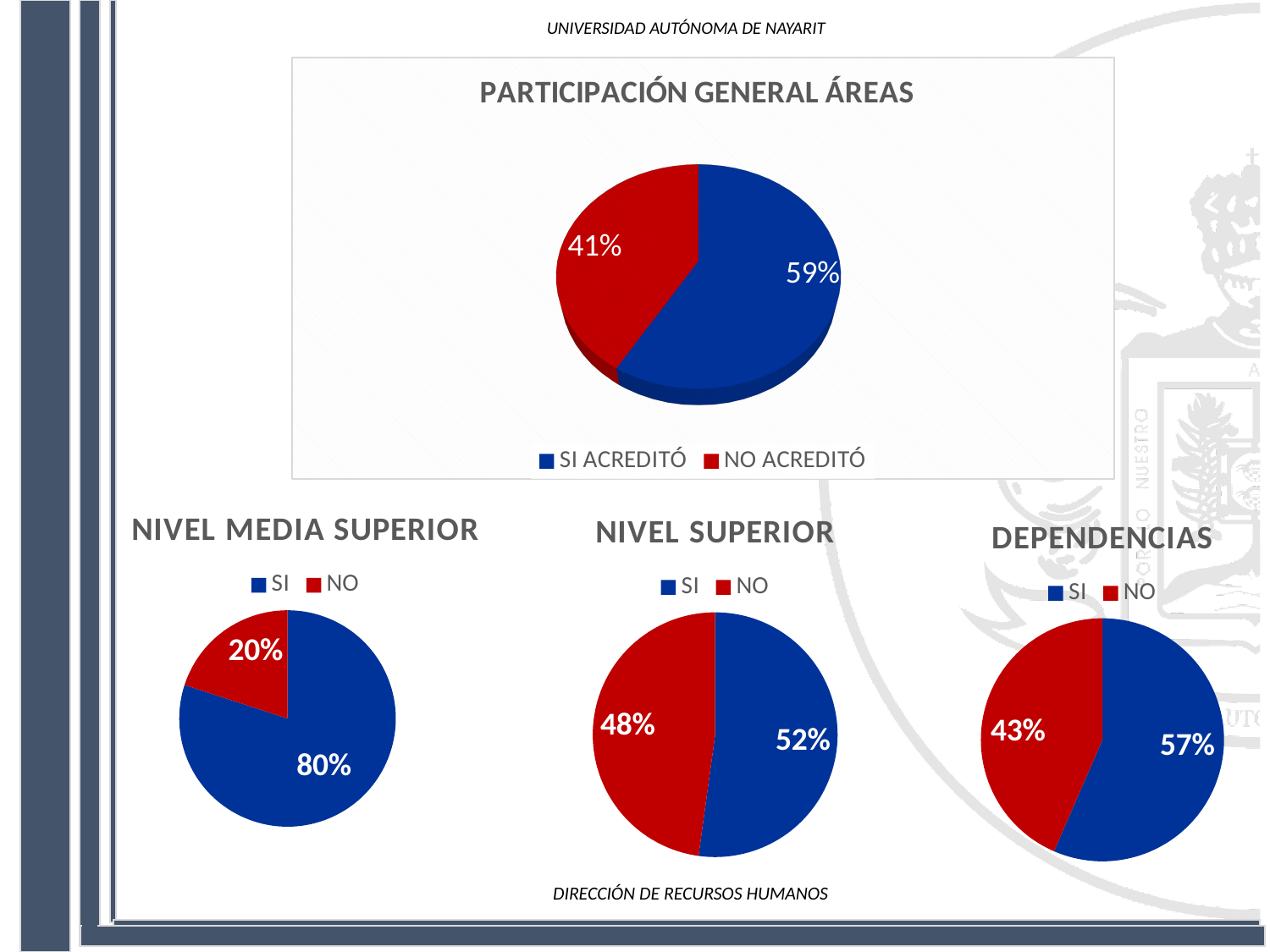
In the DEPENDENCIAS chart, what share is labelled for NO? 43% How many entries does the legend of the DEPENDENCIAS chart list? 2 What kind of chart is the PARTICIPACIÓN GENERAL ÁREAS chart? Pie chart In the PARTICIPACIÓN GENERAL ÁREAS chart, what share is labelled for SI ACREDITÓ? 59% In the NIVEL SUPERIOR chart, what share is labelled for NO? 48% In the NIVEL MEDIA SUPERIOR chart, what is the difference between the SI and NO shares? 60% In the DEPENDENCIAS chart, what is the difference between the SI and NO shares? 14% In the PARTICIPACIÓN GENERAL ÁREAS chart, which slice is larger, SI ACREDITÓ or NO ACREDITÓ? SI ACREDITÓ